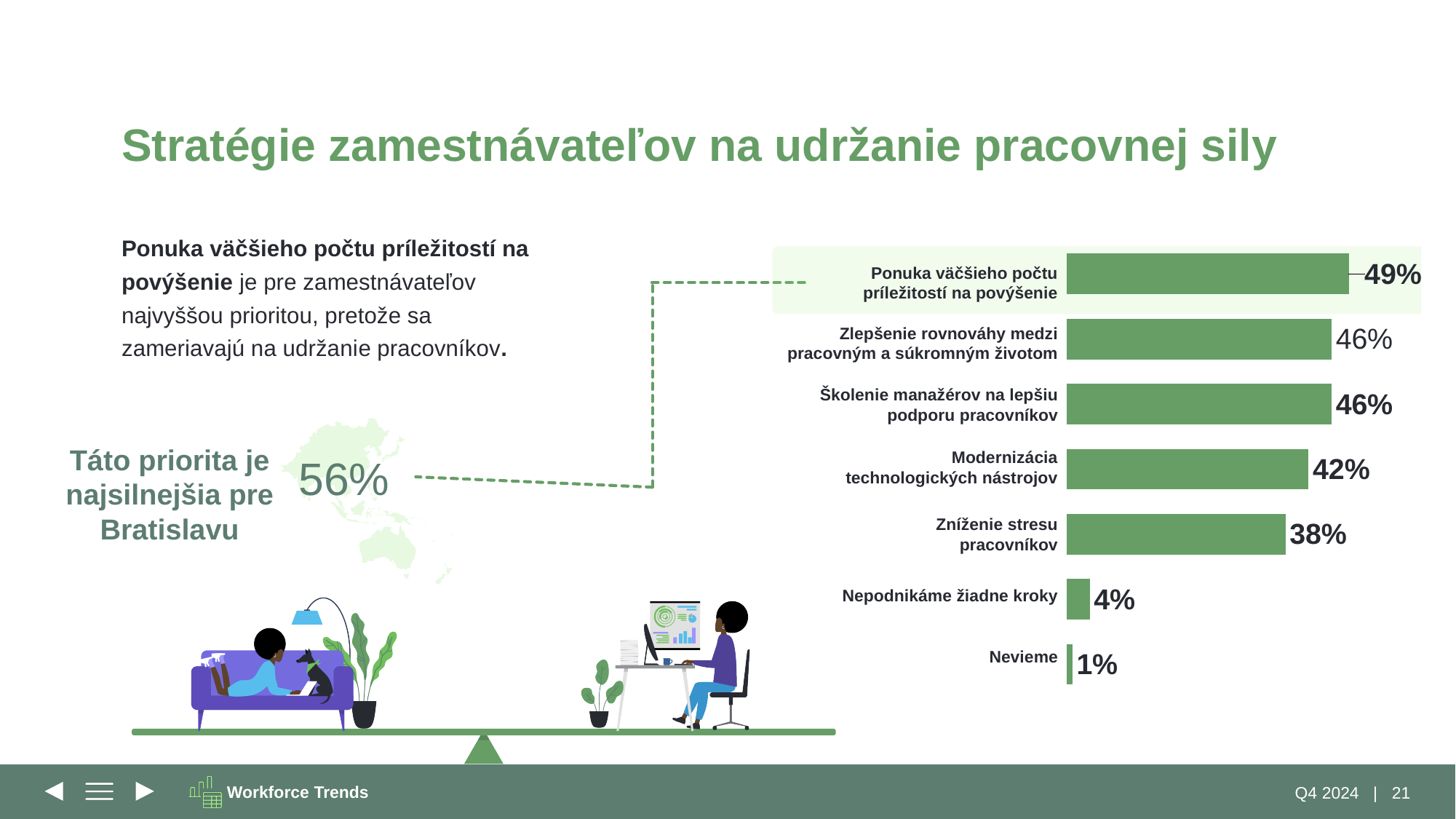
What percentage is shown for Bratislava next to the map on the left of the slide? 56% What is the value for "Modernizácia technologických nástrojov"? 42% What is the value for "Zníženie stresu pracovníkov"? 38% Which category has the highest value? Ponuka väčšieho počtu príležitostí na povýšenie What is the value for "Nepodnikáme žiadne kroky"? 4% What is the difference between "Zníženie stresu pracovníkov" and "Nepodnikáme žiadne kroky"? 34 percentage points How many categories are shown in the chart? 7 Which is larger: "Modernizácia technologických nástrojov" or "Zníženie stresu pracovníkov"? Modernizácia technologických nástrojov What kind of chart is shown on the slide? Bar chart What is the difference between "Ponuka väčšieho počtu príležitostí na povýšenie" and "Zlepšenie rovnováhy medzi pracovným a súkromným životom"? 3 percentage points Which category has the lowest value? Nevieme What is the value for "Ponuka väčšieho počtu príležitostí na povýšenie"? 49%